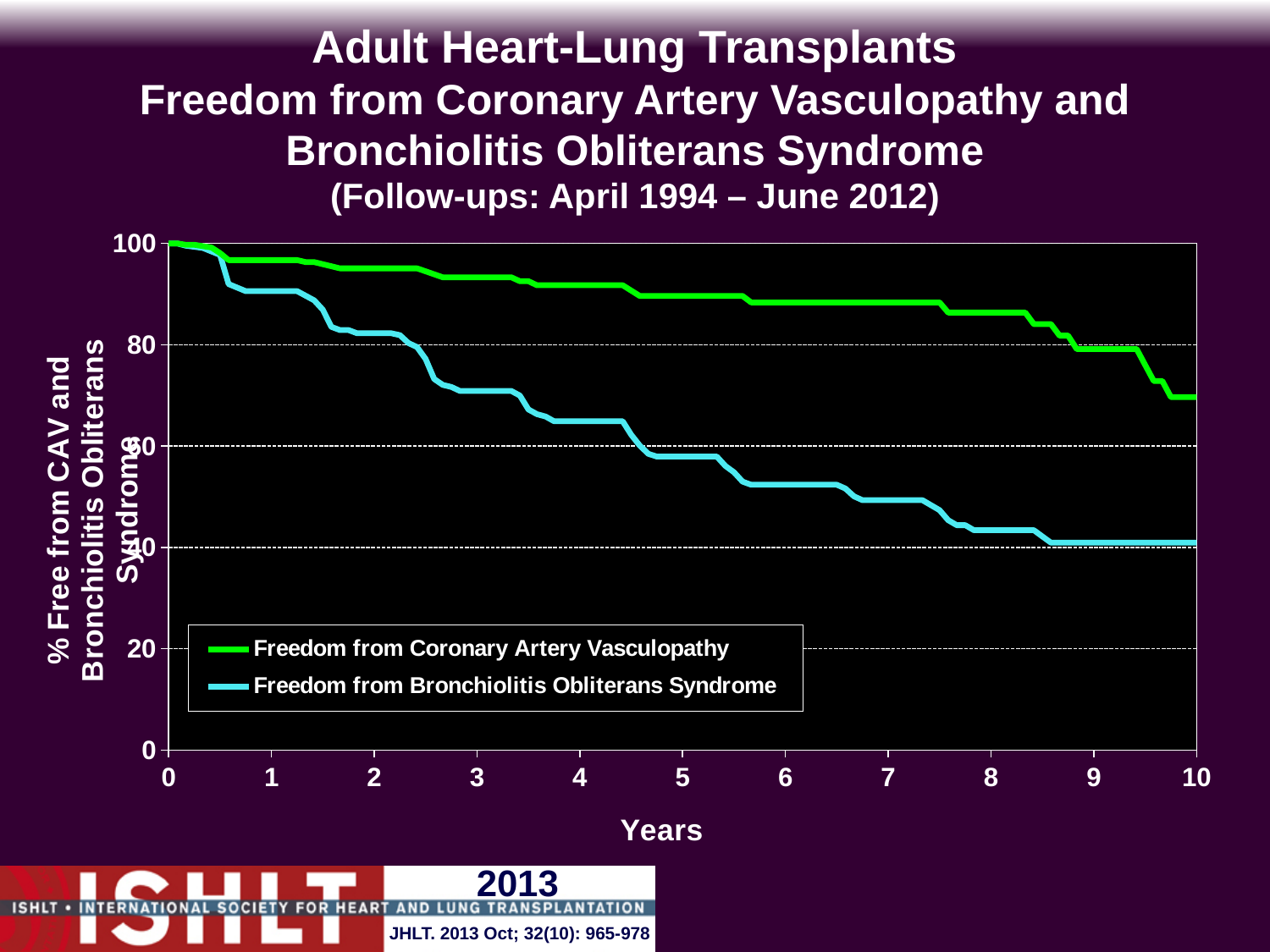
Is the value for Freedom from Coronary Artery Vasculopathy at 5 years greater or less than 80? greater What kind of chart is shown on the slide? line chart Is the value for Freedom from Coronary Artery Vasculopathy at 10 years greater or less than 80? less Which colour is used for the Freedom from Coronary Artery Vasculopathy line? green Do the values for Freedom from Bronchiolitis Obliterans Syndrome rise or fall as the years increase? fall At 5 years, which series has the higher value: Freedom from Coronary Artery Vasculopathy or Freedom from Bronchiolitis Obliterans Syndrome? Freedom from Coronary Artery Vasculopathy Do the values for Freedom from Coronary Artery Vasculopathy rise or fall as the years increase? fall How many series does the legend list? 2 Is the value for Freedom from Bronchiolitis Obliterans Syndrome at 5 years greater or less than 60? less What is the label of the x axis? Years